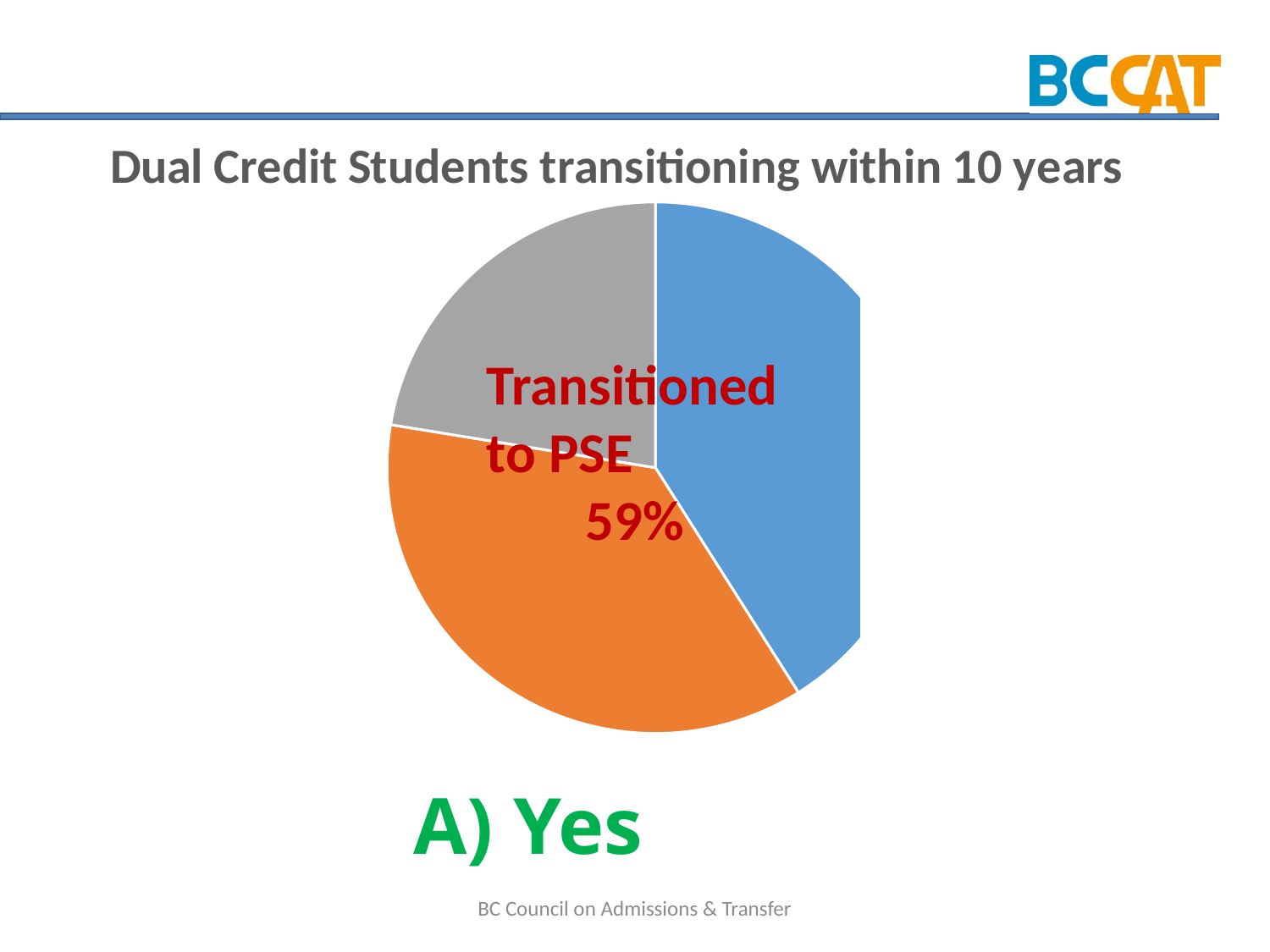
What colours are the three slices of the pie chart? blue, orange and gray What is the title of the chart? Dual Credit Students transitioning within 10 years Is the gray slice's share of the pie greater or less than 50%? less What kind of chart is shown on the slide? pie chart Which slice of the pie chart is the smallest? the gray slice Which slice is larger, the blue slice or the gray slice? the blue slice What percentage is printed on the chart for Transitioned to PSE? 59% Which slice is larger, the orange slice or the gray slice? the orange slice How many slices does the pie chart have? 3